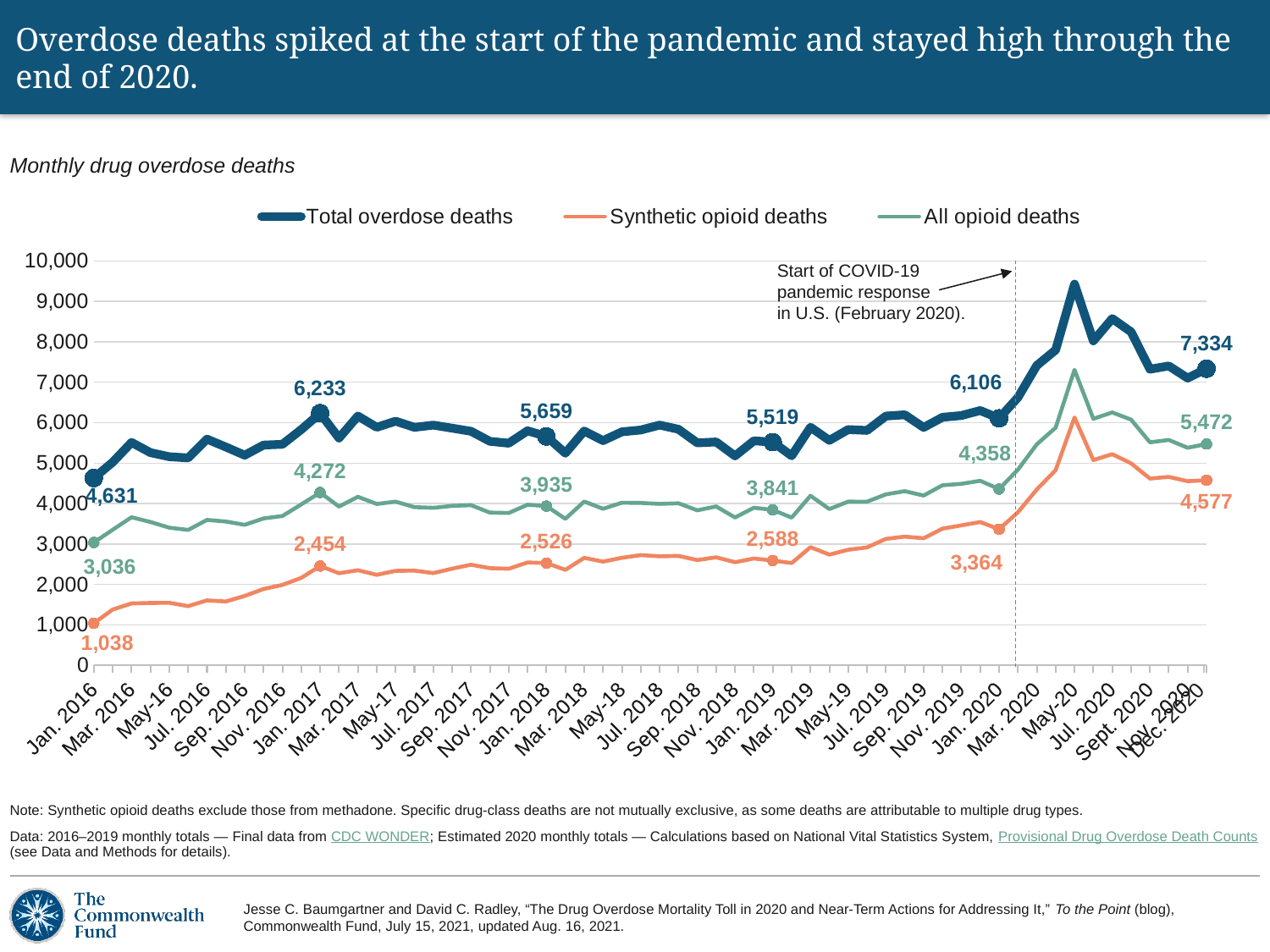
How many series does the legend list? 3 What is the value for Synthetic opioid deaths in Jan. 2016? 1,038 What is the value for Total overdose deaths in Jan. 2017? 6,233 According to the annotation, when did the COVID-19 pandemic response start in the U.S.? February 2020 Is the value for Total overdose deaths in May 2020 greater or less than 9,000? greater What kind of chart is shown on the slide? Line chart What is the value for Total overdose deaths in Dec. 2020? 7,334 Which is larger: Total overdose deaths in Jan. 2017 or in Jan. 2018? Jan. 2017 Do Synthetic opioid deaths generally rise or fall from Jan. 2016 to Dec. 2020? Rise What is the difference between Total overdose deaths in Dec. 2020 and Jan. 2016? 2,703 What is the value for All opioid deaths in Jan. 2020? 4,358 What is the difference between All opioid deaths and Synthetic opioid deaths in Dec. 2020? 895